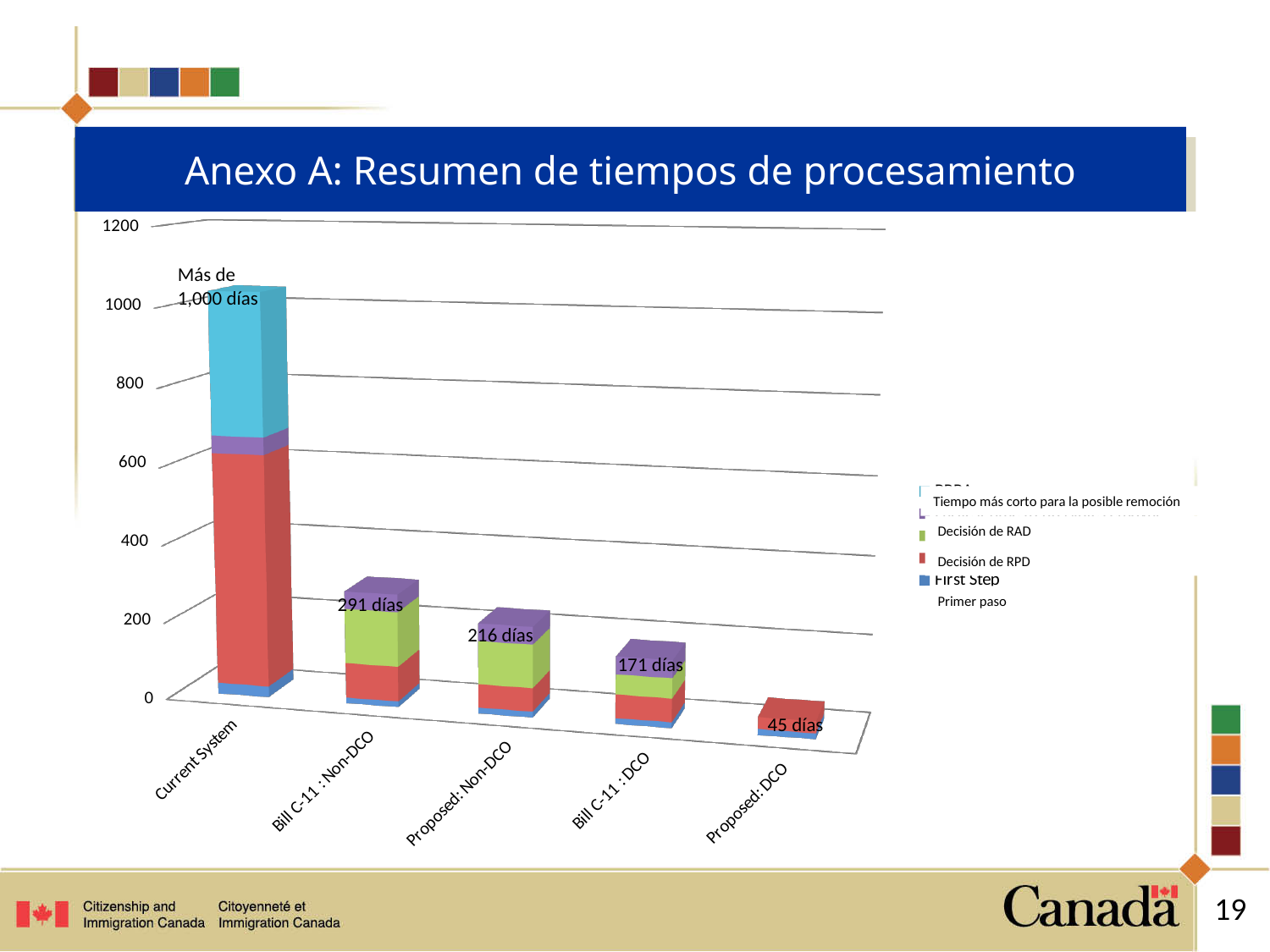
What is the total processing time shown for Bill C-11 : Non-DCO? 291 días What is the difference in days between Bill C-11 : DCO and Proposed: DCO? 126 días Is the total value for Current System greater or less than 800? greater Which category has the highest total processing time? Current System What is the total processing time shown for Bill C-11 : DCO? 171 días How many categories are shown on the x axis? 5 Which has a larger total processing time, Proposed: Non-DCO or Bill C-11 : DCO? Proposed: Non-DCO Which category has the lowest total processing time? Proposed: DCO What is the difference in days between Bill C-11 : Non-DCO and Proposed: Non-DCO? 75 días What kind of chart is shown on the slide? Stacked bar chart What is the total processing time shown for Proposed: Non-DCO? 216 días What is the total processing time shown for Proposed: DCO? 45 días